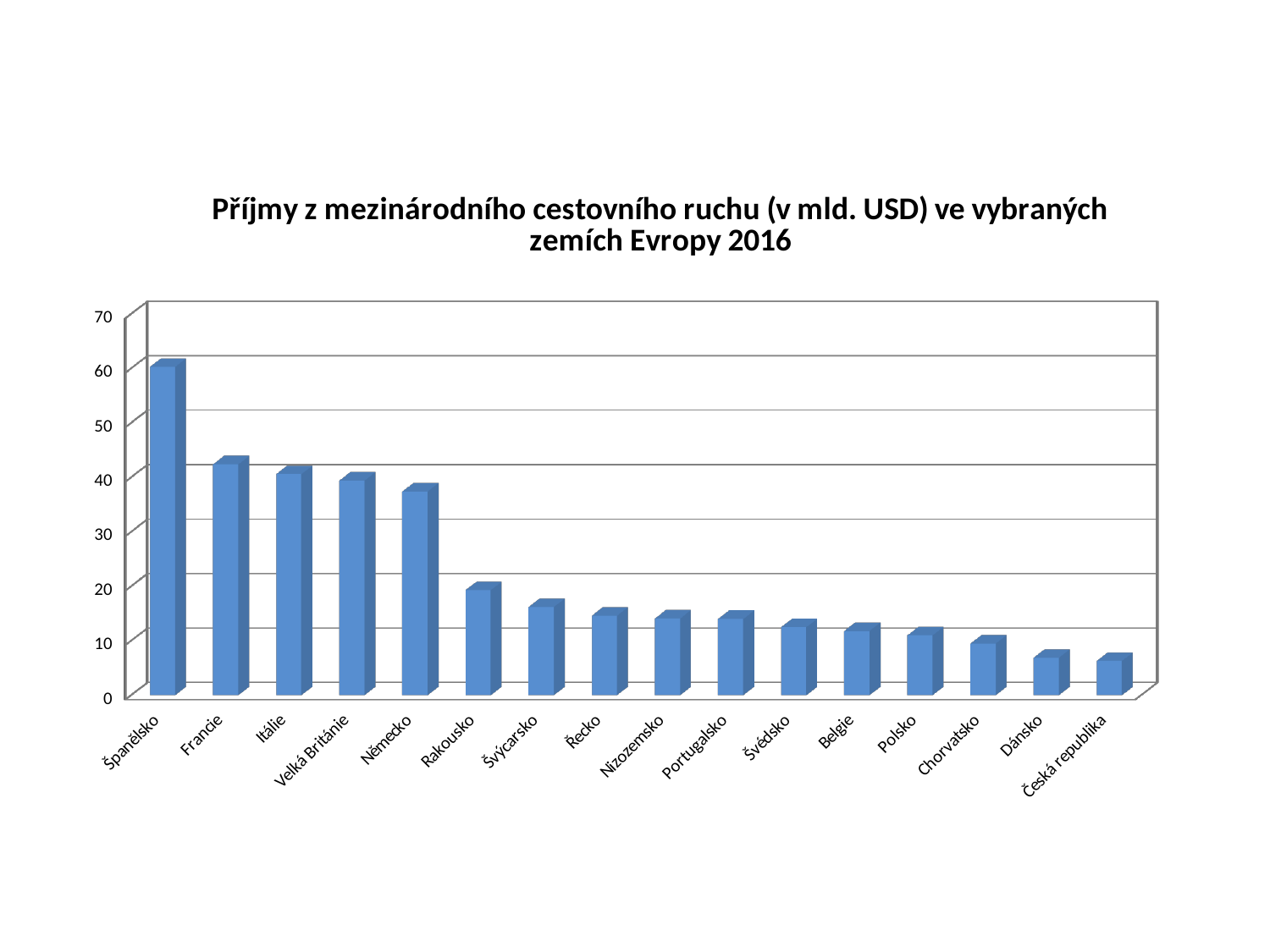
Which has a larger value, Německo or Rakousko? Německo Which has a larger value, Španělsko or Francie? Španělsko Which country has the highest value on the chart? Španělsko Is the value for Rakousko greater or less than 10? greater Is the value for Španělsko greater or less than 50? greater Do the values rise or fall from left to right along the x axis? fall Is the value for Česká republika greater or less than 10? less Which country has the lowest value on the chart? Česká republika How many countries are shown on the chart? 16 What kind of chart is shown on the slide? bar chart